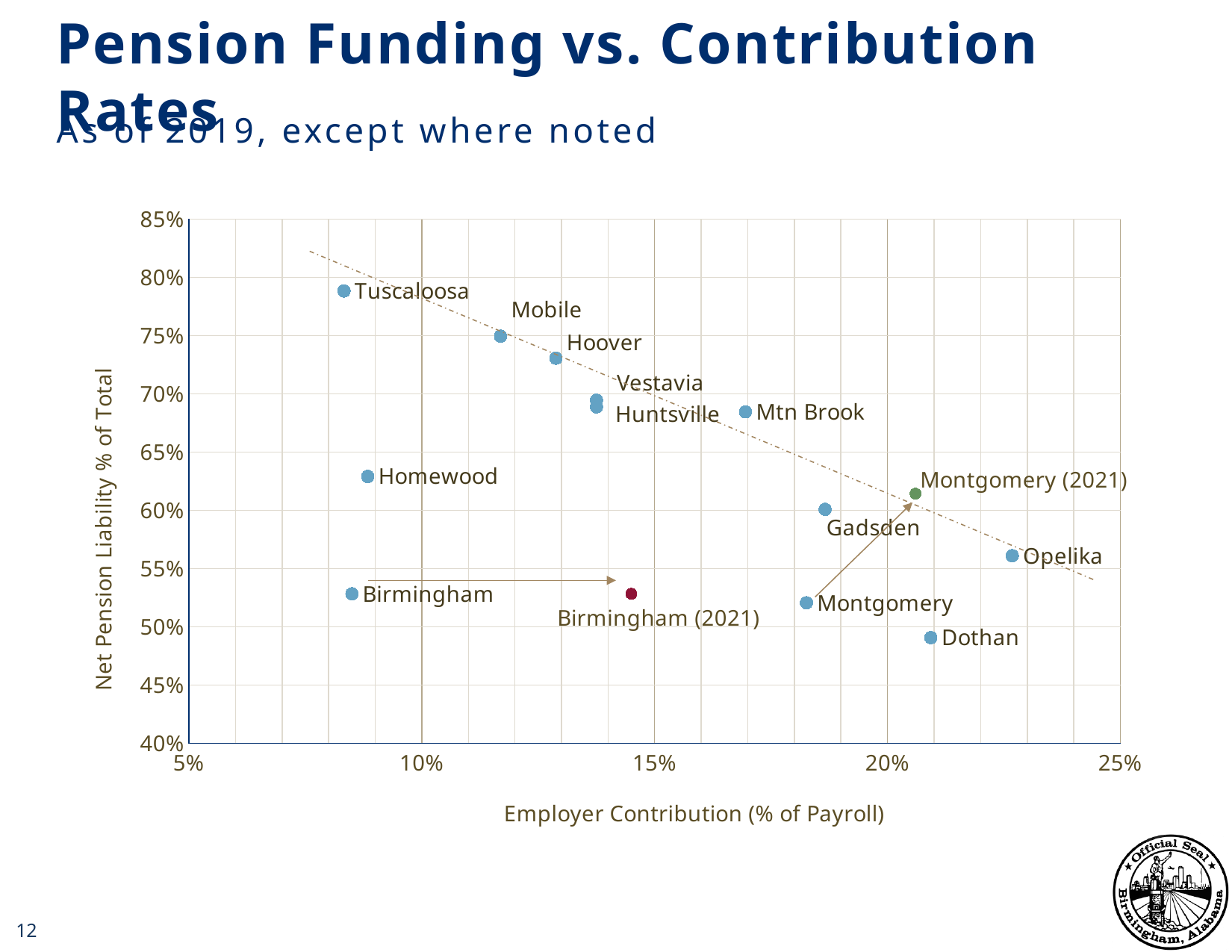
Which city has the highest Employer Contribution (% of Payroll)? Opelika Which city has the lowest Net Pension Liability % of Total? Dothan What kind of chart is shown on the slide? scatter chart As Employer Contribution increases along the x axis, does the dashed trend line rise or fall? fall What is the title of the x axis? Employer Contribution (% of Payroll) Is the Net Pension Liability value for Tuscaloosa greater or less than 75%? greater Which has a higher Net Pension Liability % of Total, Mobile or Hoover? Mobile How many cities or data points are plotted on the chart? 14 Is the Net Pension Liability value for Homewood greater or less than 60%? greater Is the Net Pension Liability value for Birmingham greater or less than 55%? less Which city has the highest Net Pension Liability % of Total? Tuscaloosa